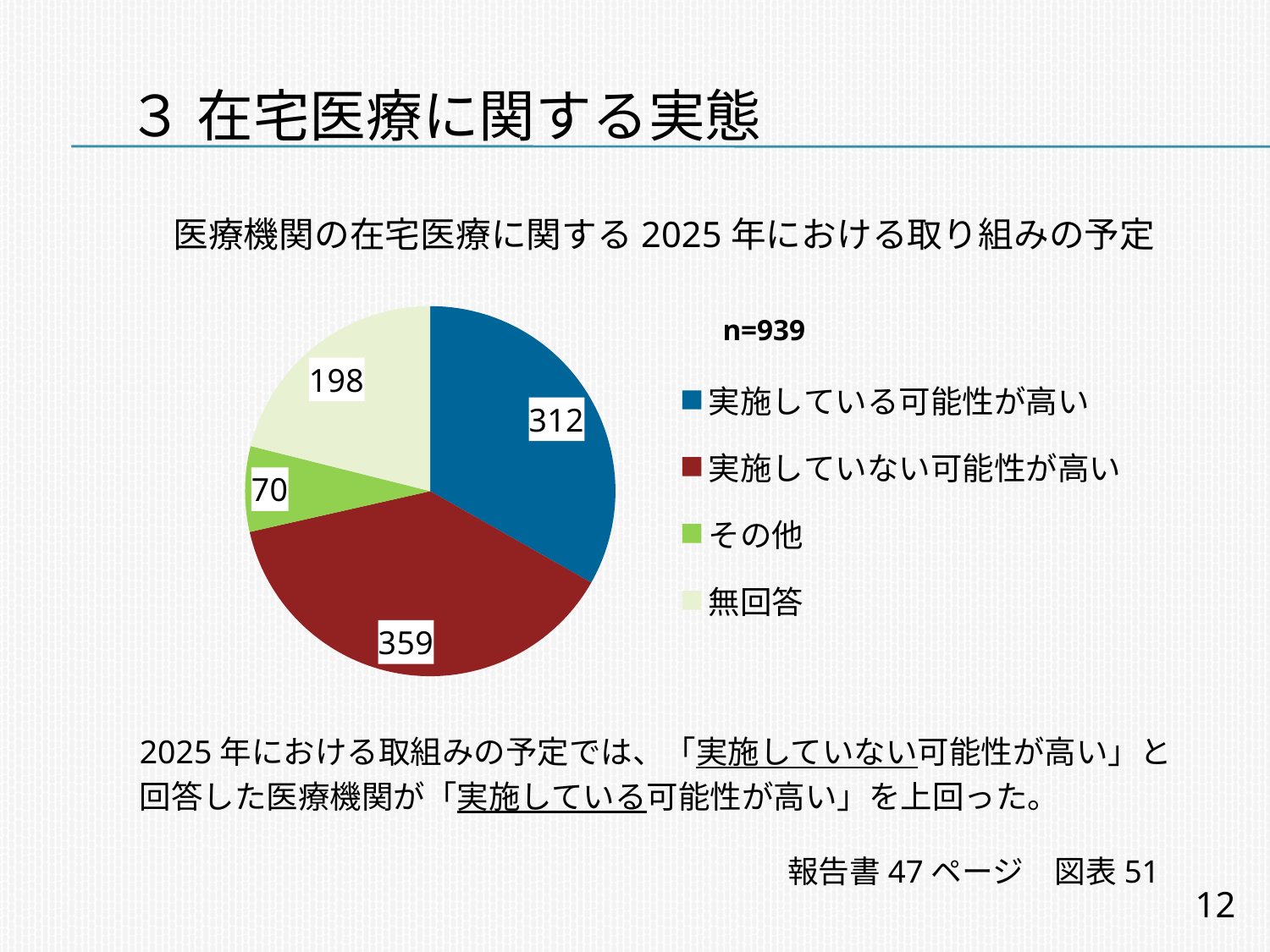
What value is shown for the 実施している可能性が高い slice of the pie chart? 312 What is the total of all slices in the pie chart? 939 What value is shown for the その他 slice? 70 What is the sample size (n) shown next to the pie chart? n=939 What is the difference between the 実施していない可能性が高い value and the 実施している可能性が高い value? 47 What value is shown for the 実施していない可能性が高い slice? 359 What kind of chart is shown on the slide? Pie chart What value is shown for the 無回答 slice? 198 Which category has the smallest slice in the pie chart? その他 Which category has the largest slice in the pie chart? 実施していない可能性が高い Which is larger, the 無回答 value or the その他 value? 無回答 How many categories does the pie chart show? 4